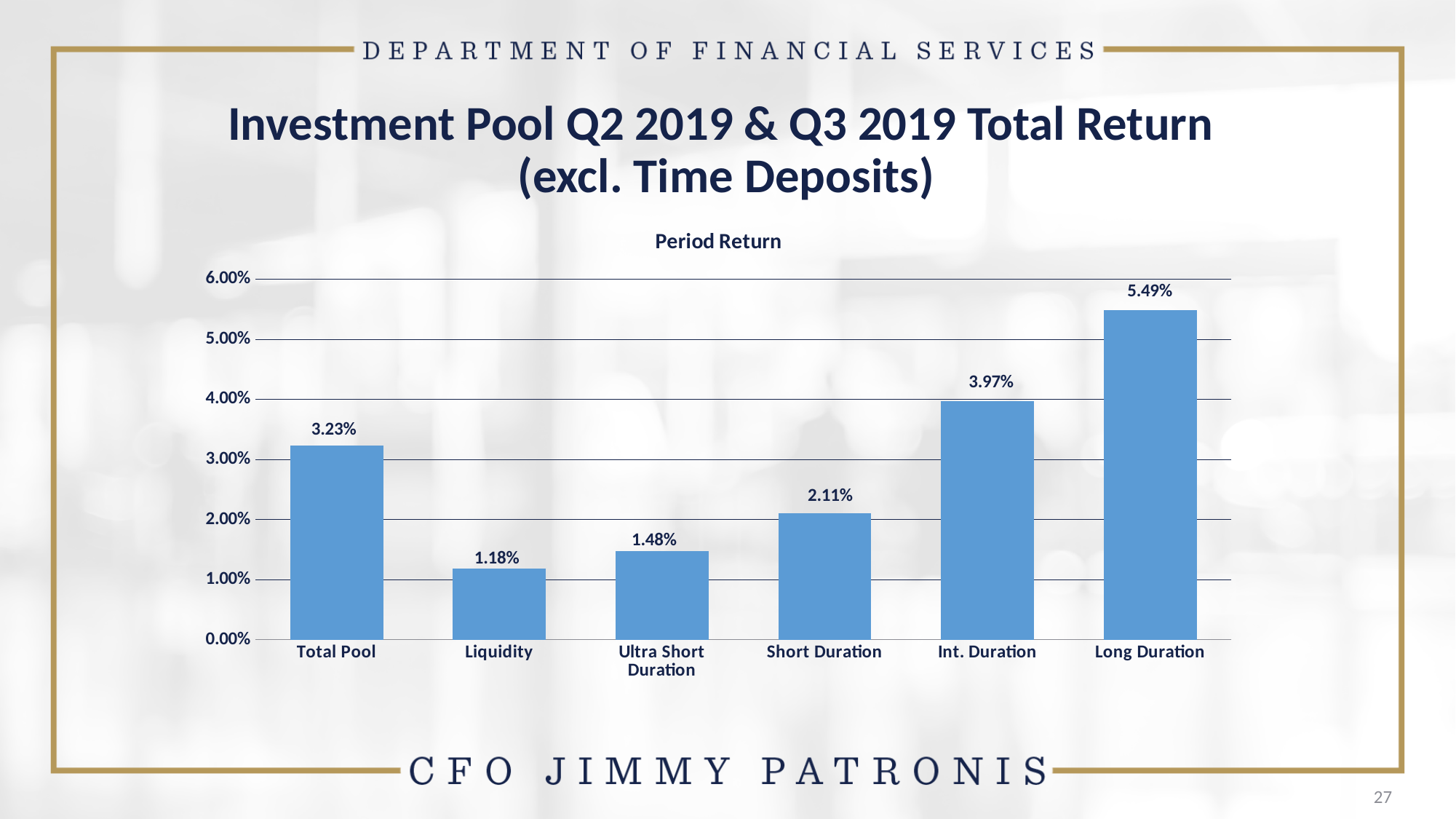
Which has a higher period return, Short Duration or Ultra Short Duration? Short Duration Which category has the lowest period return? Liquidity What is the period return for Total Pool? 3.23% What is the title of the chart? Period Return What kind of chart is shown on the slide? Bar chart What is the period return for Ultra Short Duration? 1.48% What is the difference between the period return for Long Duration and Short Duration? 3.38% What is the period return for Int. Duration? 3.97% Which category has the highest period return? Long Duration Is the period return for Int. Duration greater or less than 4.00%? less What is the period return for Liquidity? 1.18% How many categories are shown on the chart? 6